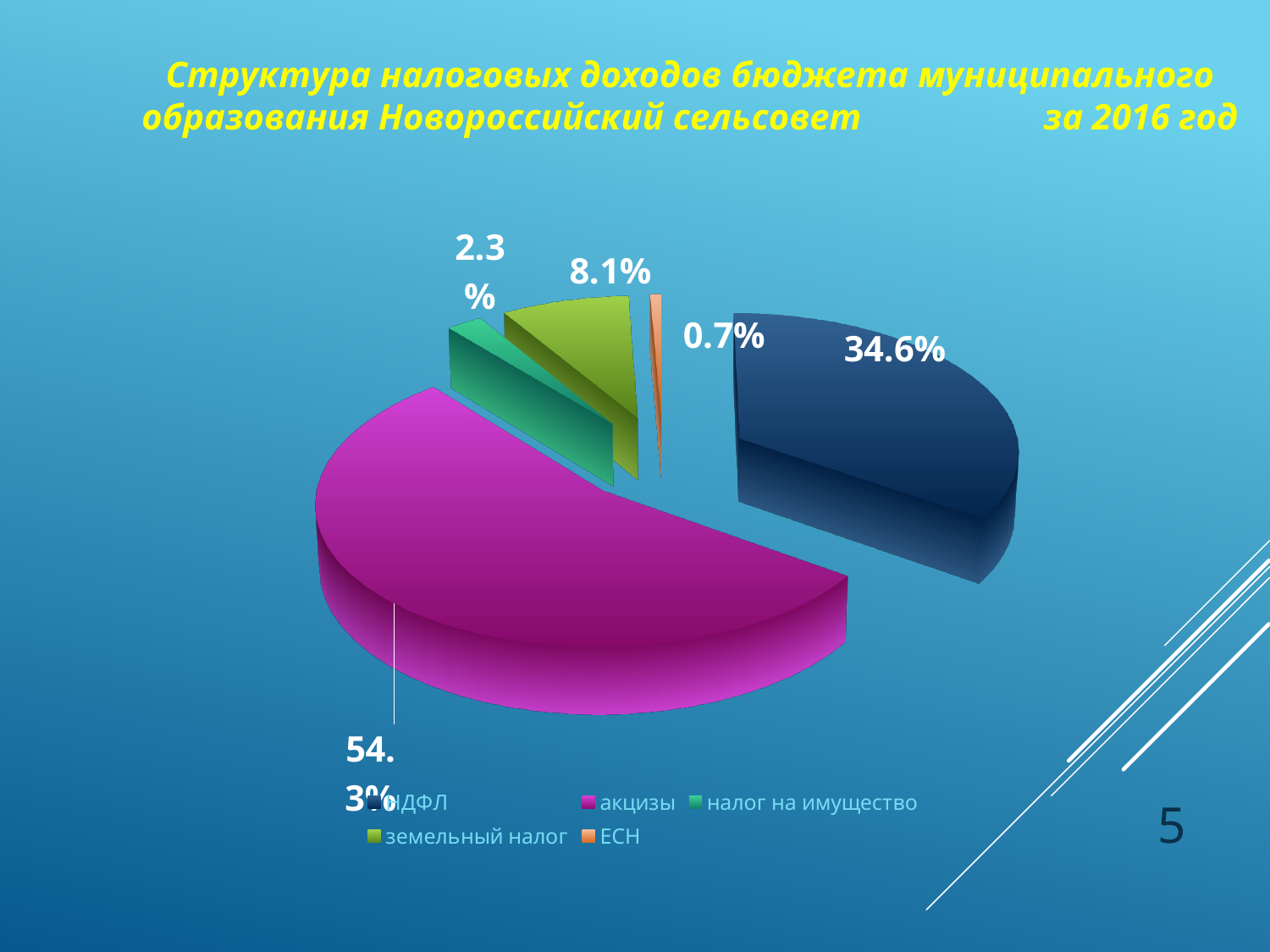
What colour is the slice for акцизы? magenta What share of the pie does акцизы have? 54.3% What is the difference between the share for земельный налог and the share for налог на имущество? 5.8% What share of the pie does ЕСН have? 0.7% What kind of chart is shown on the slide? pie chart How many categories does the legend list? 5 Which category has the smallest share of the pie? ЕСН What share of the pie does земельный налог have? 8.1% Which category has the largest share of the pie? акцизы What share of the pie does НДФЛ have? 34.6% Which is larger, the share for НДФЛ or the share for земельный налог? НДФЛ What share of the pie does налог на имущество have? 2.3%